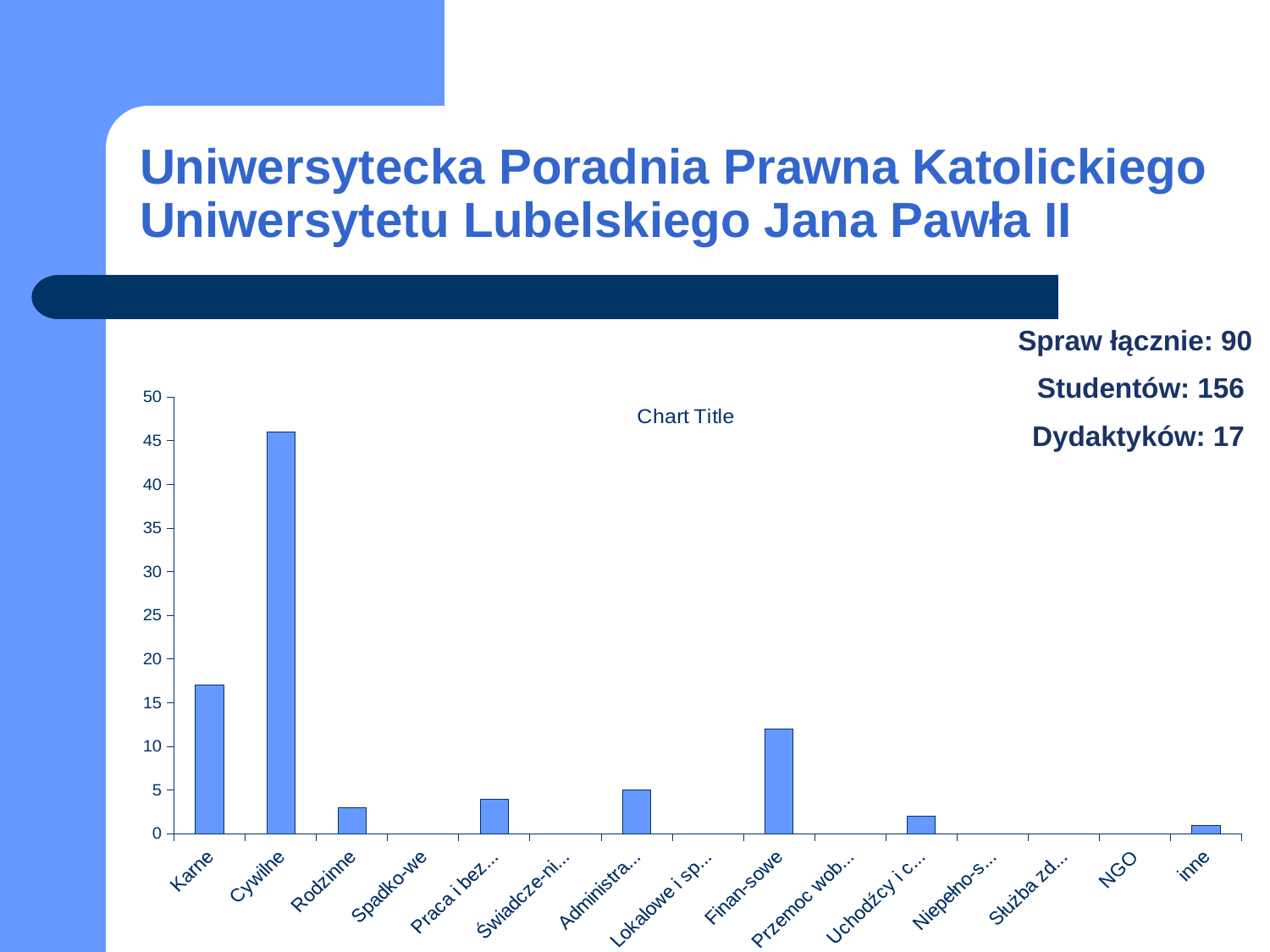
Is the value for Finan-sowe greater or less than 10? greater What is the title shown on the chart? Chart Title What kind of chart is shown on the slide? bar chart Is the value for Cywilne greater or less than 40? greater Is the value for Karne greater or less than 15? greater How many categories are shown on the x axis? 15 Which is larger, the value for Cywilne or the value for Karne? Cywilne Which category has the highest bar? Cywilne Which is larger, the value for Karne or the value for Finan-sowe? Karne What is the highest value shown on the y axis? 50